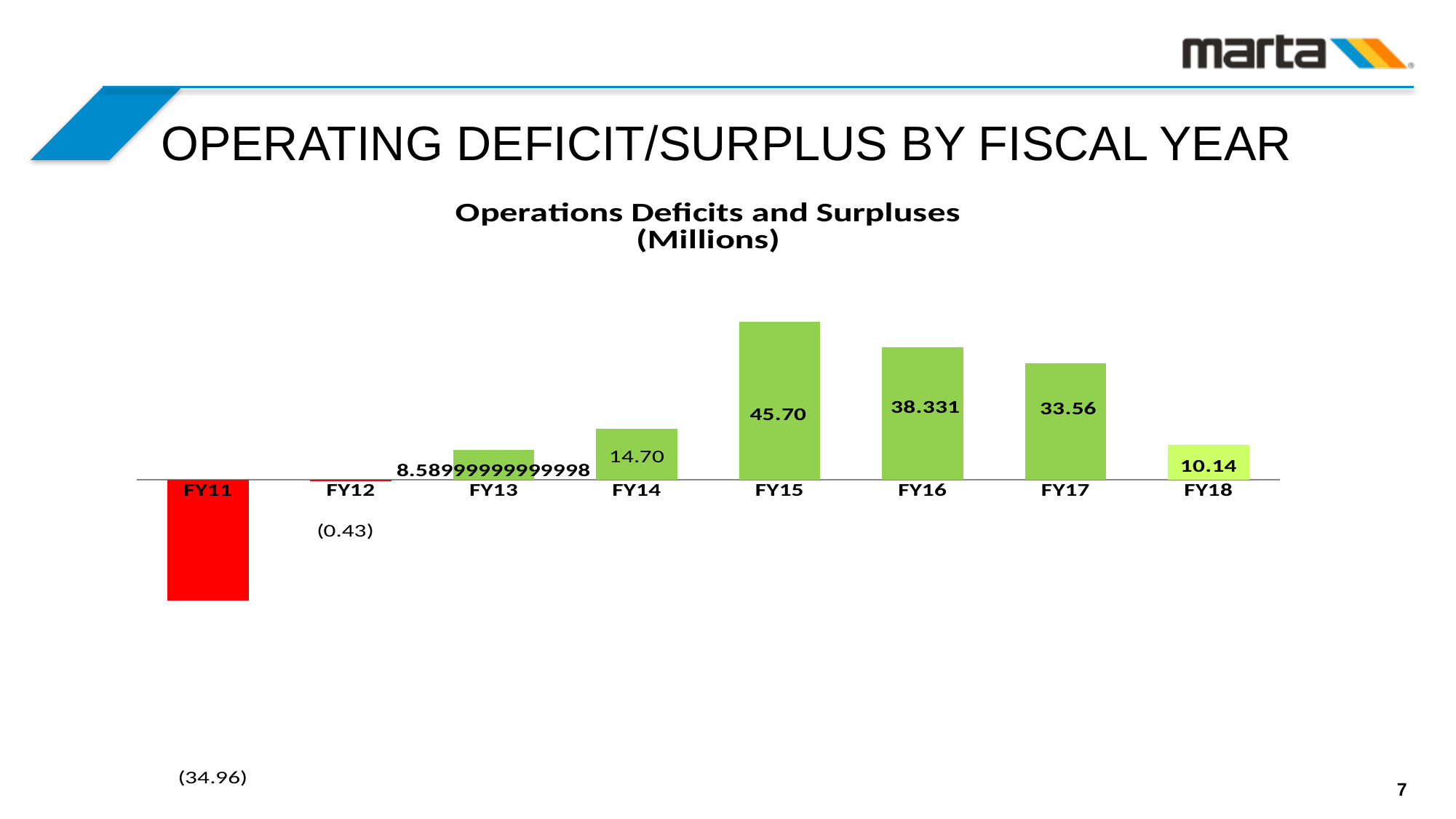
What is the value shown for FY12? (0.43) What is the value shown for FY15? 45.70 Do the values rise or fall from FY15 to FY18? Fall What is the difference between the FY17 and FY18 values? 23.42 What kind of chart is shown on the slide? Bar chart What is the difference between the FY15 and FY16 values? 7.369 Which is larger, the value for FY14 or the value for FY18? FY14 Which fiscal year has the highest value? FY15 What is the value shown for FY11? (34.96) What is the value shown for FY16? 38.331 Which fiscal year has the lowest value? FY11 How many fiscal years are shown on the chart? 8